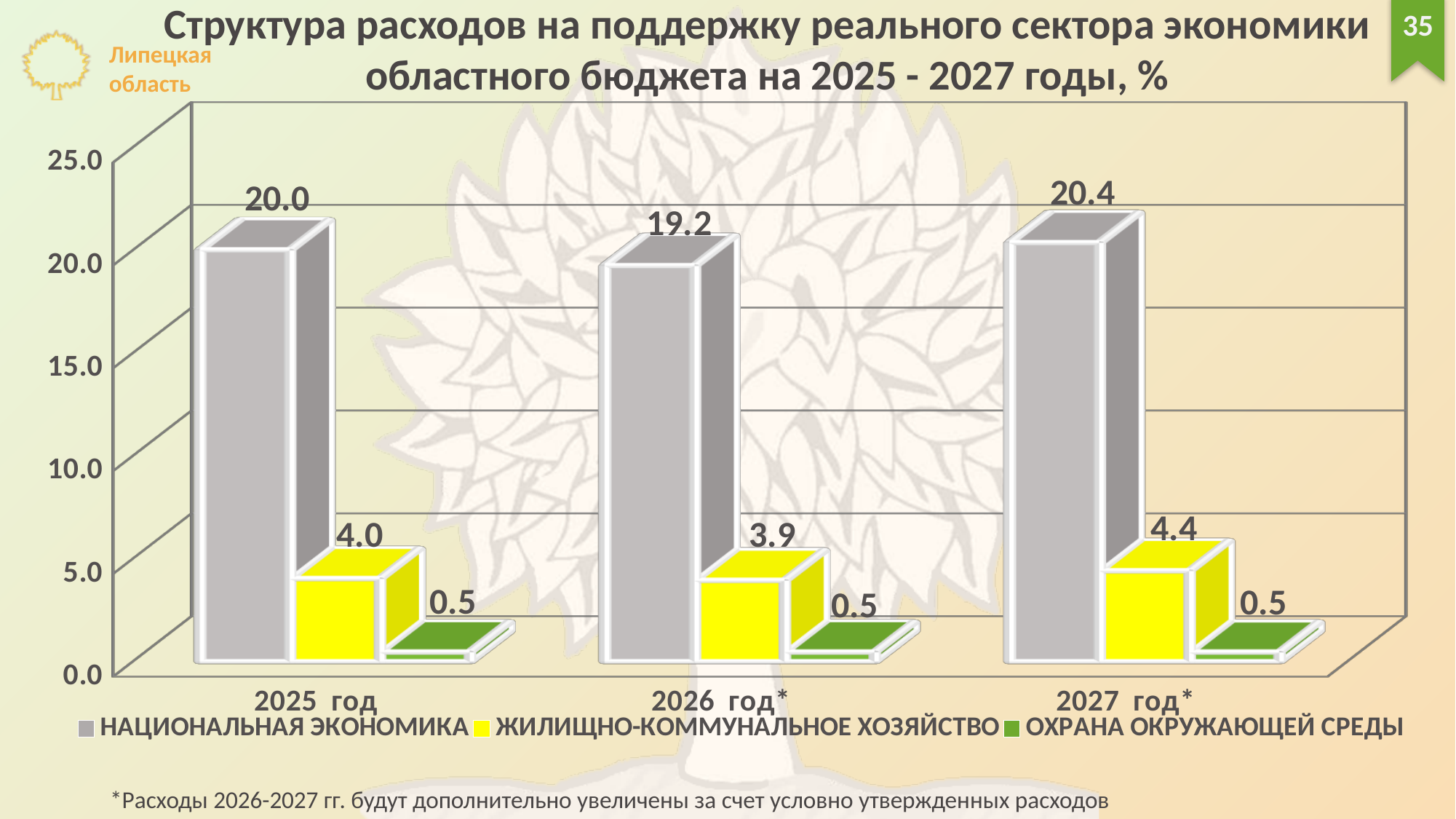
Значение «Национальная экономика» в 2026 году больше или меньше 20.0? меньше Каким цветом на диаграмме обозначен ряд «Охрана окружающей среды»? Зелёным Какое значение имеет показатель «Охрана окружающей среды» в 2026 году? 0.5 Какое значение имеет показатель «Жилищно-коммунальное хозяйство» в 2027 году? 4.4 Какого типа эта диаграмма? Столбчатая (bar chart) Какое значение имеет показатель «Национальная экономика» в 2025 году? 20.0 На сколько значение «Национальная экономика» в 2027 году больше, чем в 2026 году? 1.2 В каком году значение показателя «Жилищно-коммунальное хозяйство» наименьшее? 2026 год В каком году значение показателя «Национальная экономика» наибольшее? 2027 год Сколько лет (категорий) показано на диаграмме? 3 Сколько рядов данных указано в легенде диаграммы? 3 Что больше: «Жилищно-коммунальное хозяйство» в 2025 году или в 2027 году? 2027 год